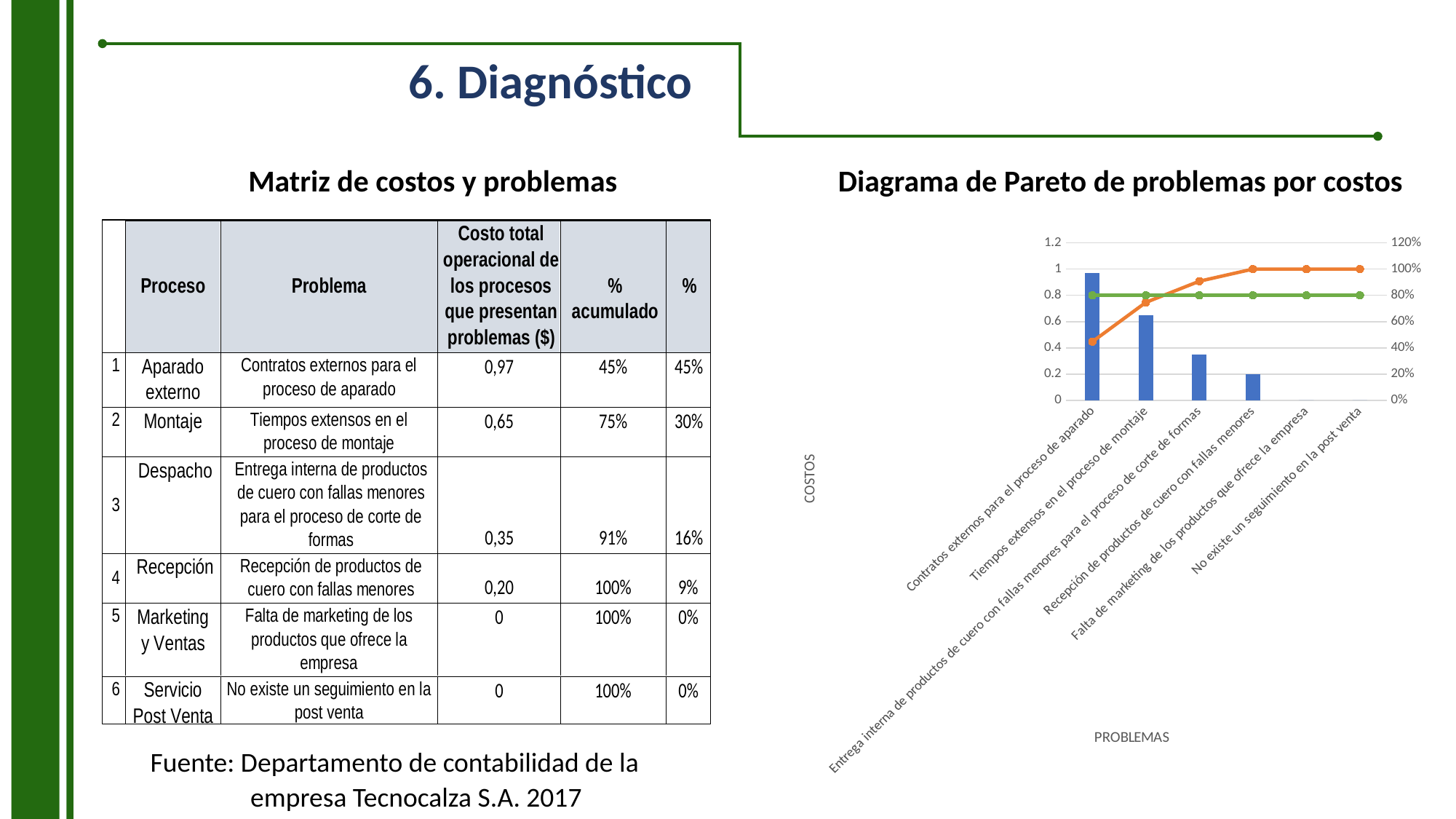
In the Pareto chart, which bar is taller: 'Tiempos extensos en el proceso de montaje' or 'Entrega interna de productos de cuero con fallas menores para el proceso de corte de formas'? Tiempos extensos en el proceso de montaje What is the title of the horizontal axis of the Pareto chart? PROBLEMAS In the Pareto chart, at what percentage does the flat green line sit on the right axis? 80% What kind of chart is the Diagrama de Pareto de problemas por costos? bar chart with lines In the Pareto chart, is the bar for 'Entrega interna de productos de cuero con fallas menores para el proceso de corte de formas' greater or less than 0.2? greater In the Pareto chart, do the bars rise or fall from left to right along the x axis? fall In the Pareto chart, what value does the bar for 'Recepción de productos de cuero con fallas menores' reach on the left axis? 0.2 In the Pareto chart, is the bar for 'Tiempos extensos en el proceso de montaje' greater or less than 0.8? less In the Pareto chart, which problem has the highest bar? Contratos externos para el proceso de aparado In the Pareto chart, is the bar for 'Contratos externos para el proceso de aparado' greater or less than 0.8? greater How many problem categories are shown on the x axis of the Pareto chart? 6 In the Pareto chart, what value does the orange cumulative line reach at 'No existe un seguimiento en la post venta'? 100%